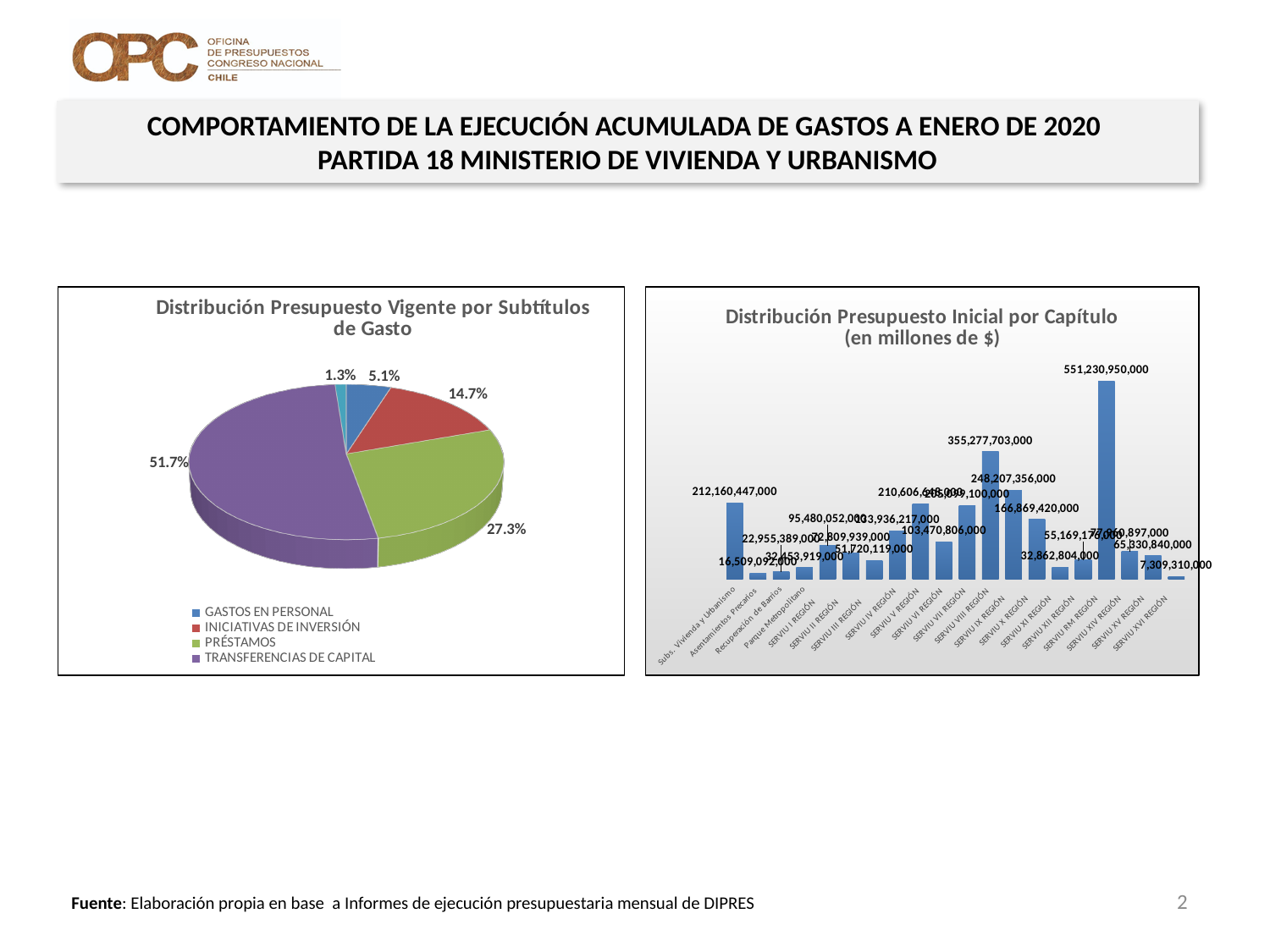
On the pie chart 'Distribución Presupuesto Vigente por Subtítulos de Gasto', how many entries does the legend list? 4 On the pie chart 'Distribución Presupuesto Vigente por Subtítulos de Gasto', what share does PRÉSTAMOS have? 27.3% On the pie chart 'Distribución Presupuesto Vigente por Subtítulos de Gasto', what is the difference in percentage points between TRANSFERENCIAS DE CAPITAL and PRÉSTAMOS? 24.4 percentage points On the chart 'Distribución Presupuesto Inicial por Capítulo', how many capítulos are shown on the x axis? 20 What kind of chart is 'Distribución Presupuesto Inicial por Capítulo (en millones de $)'? Bar chart On the chart 'Distribución Presupuesto Inicial por Capítulo', what is the value for SERVIU VIII REGIÓN? 355,277,703,000 On the pie chart 'Distribución Presupuesto Vigente por Subtítulos de Gasto', which legend category has the largest slice? TRANSFERENCIAS DE CAPITAL On the pie chart 'Distribución Presupuesto Vigente por Subtítulos de Gasto', what share does TRANSFERENCIAS DE CAPITAL have? 51.7% On the chart 'Distribución Presupuesto Inicial por Capítulo', which capítulo has the highest value? SERVIU RM REGIÓN On the chart 'Distribución Presupuesto Inicial por Capítulo', what is the value for SERVIU RM REGIÓN? 551,230,950,000 On the chart 'Distribución Presupuesto Inicial por Capítulo', which capítulo has the lowest value? SERVIU XVI REGIÓN On the chart 'Distribución Presupuesto Inicial por Capítulo', which is larger: SERVIU VIII REGIÓN or SERVIU IX REGIÓN? SERVIU VIII REGIÓN